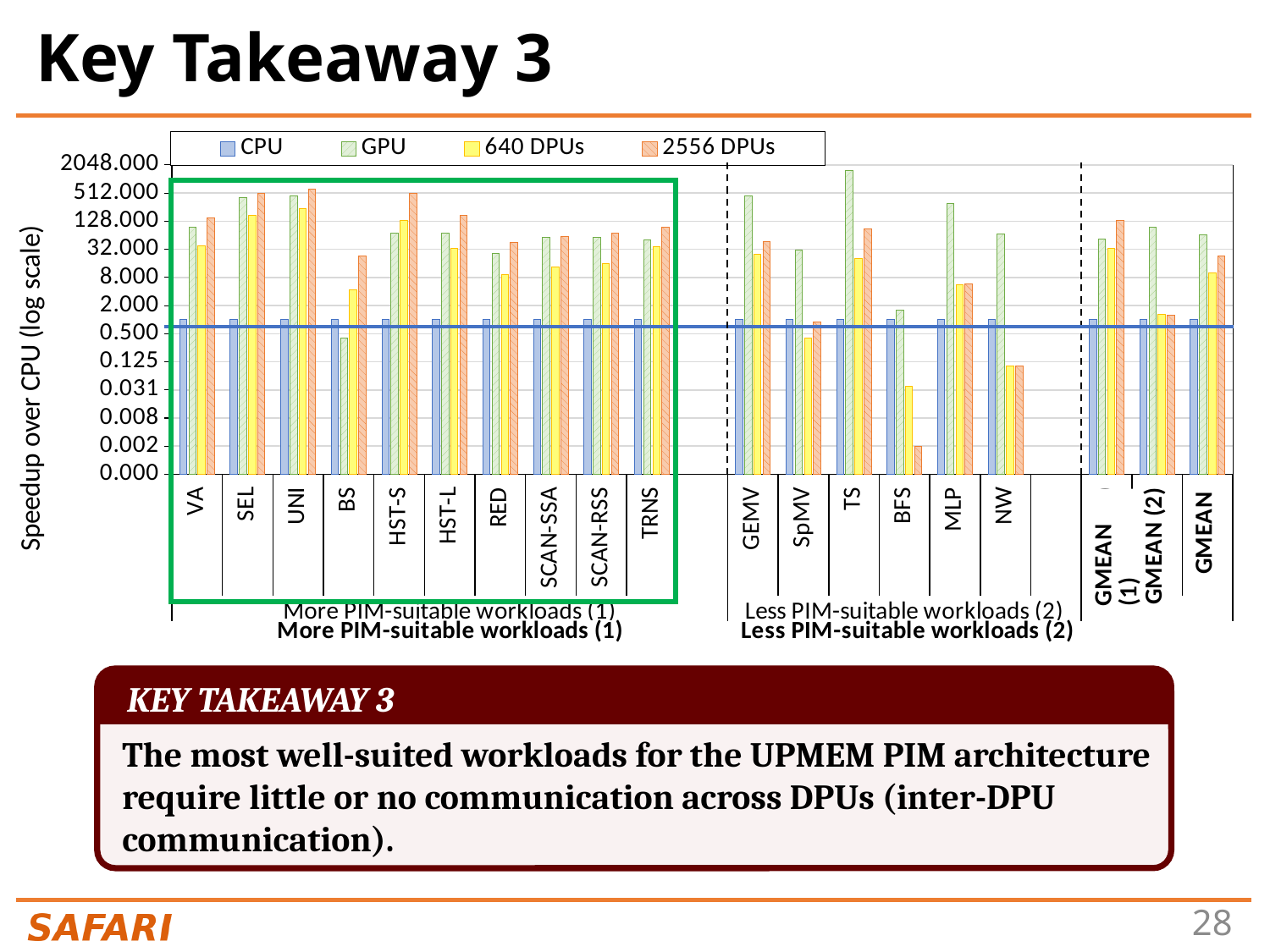
How many workloads are in the 'Less PIM-suitable workloads (2)' group? 6 Which workload has the highest GPU speedup? TS For BFS, which is larger: the GPU value or the 640 DPUs value? GPU Is the GPU value for TS greater or less than 512? greater Is the 2556 DPUs value for BFS greater or less than 0.008? less Is the GPU value for GEMV greater or less than 128? greater How many series does the legend list? 4 How many workloads are in the 'More PIM-suitable workloads (1)' group? 10 What is the label of the y axis? Speedup over CPU (log scale) What kind of chart is shown on the slide? bar chart Which series are listed in the legend? CPU, GPU, 640 DPUs, 2556 DPUs